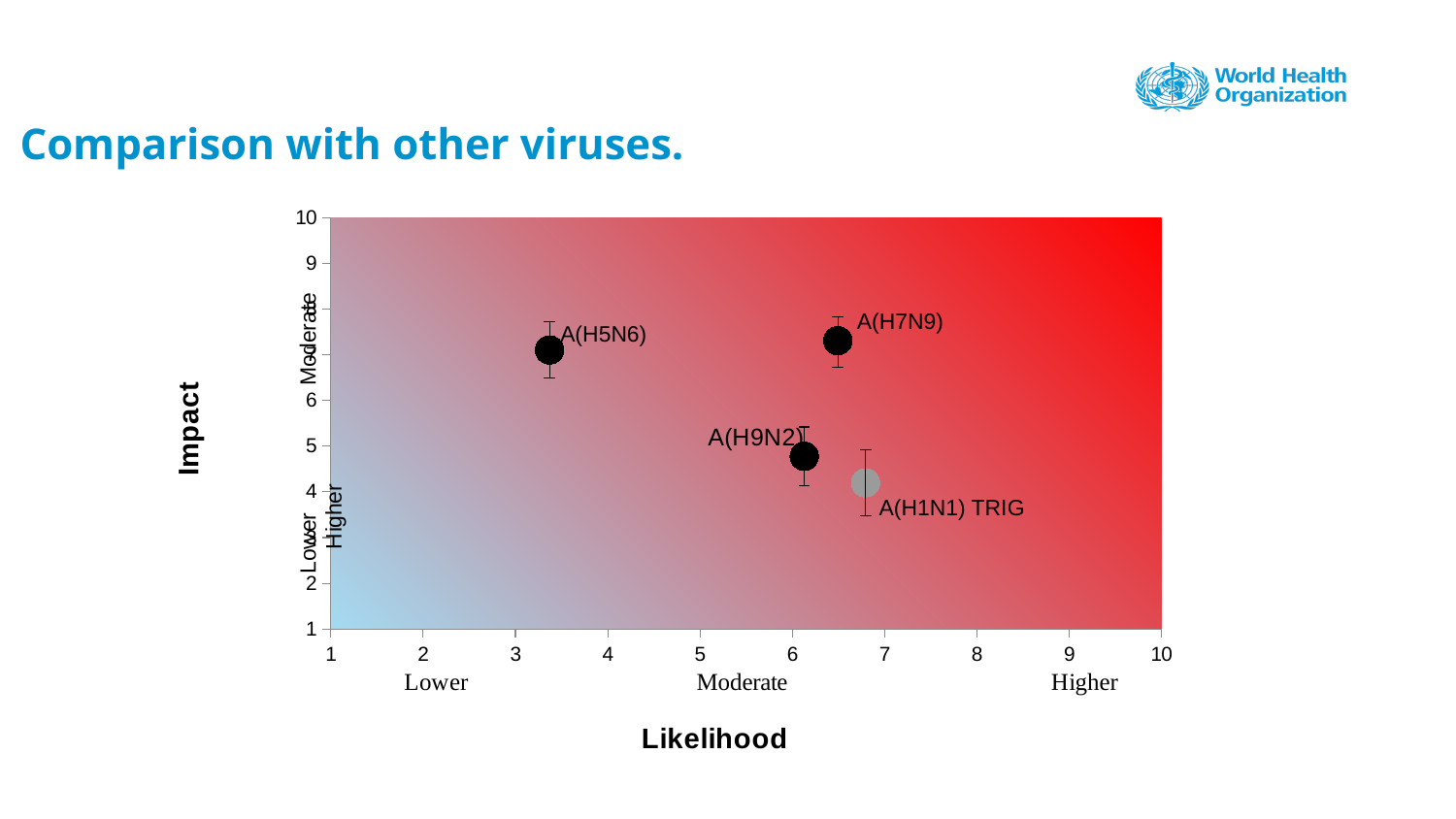
Is the impact value for A(H1N1) TRIG greater or less than 5? less Is the impact value for A(H9N2) greater or less than 6? less What is the label of the horizontal axis? Likelihood Is the likelihood value for A(H7N9) greater or less than 6? greater Which has the higher likelihood, A(H5N6) or A(H7N9)? A(H7N9) Which has the higher impact, A(H7N9) or A(H9N2)? A(H7N9) Which virus has the lowest likelihood on the chart? A(H5N6) How many viruses are plotted on the chart? 4 What is the title of the slide containing the chart? Comparison with other viruses. What kind of chart is shown on the slide? scatter chart